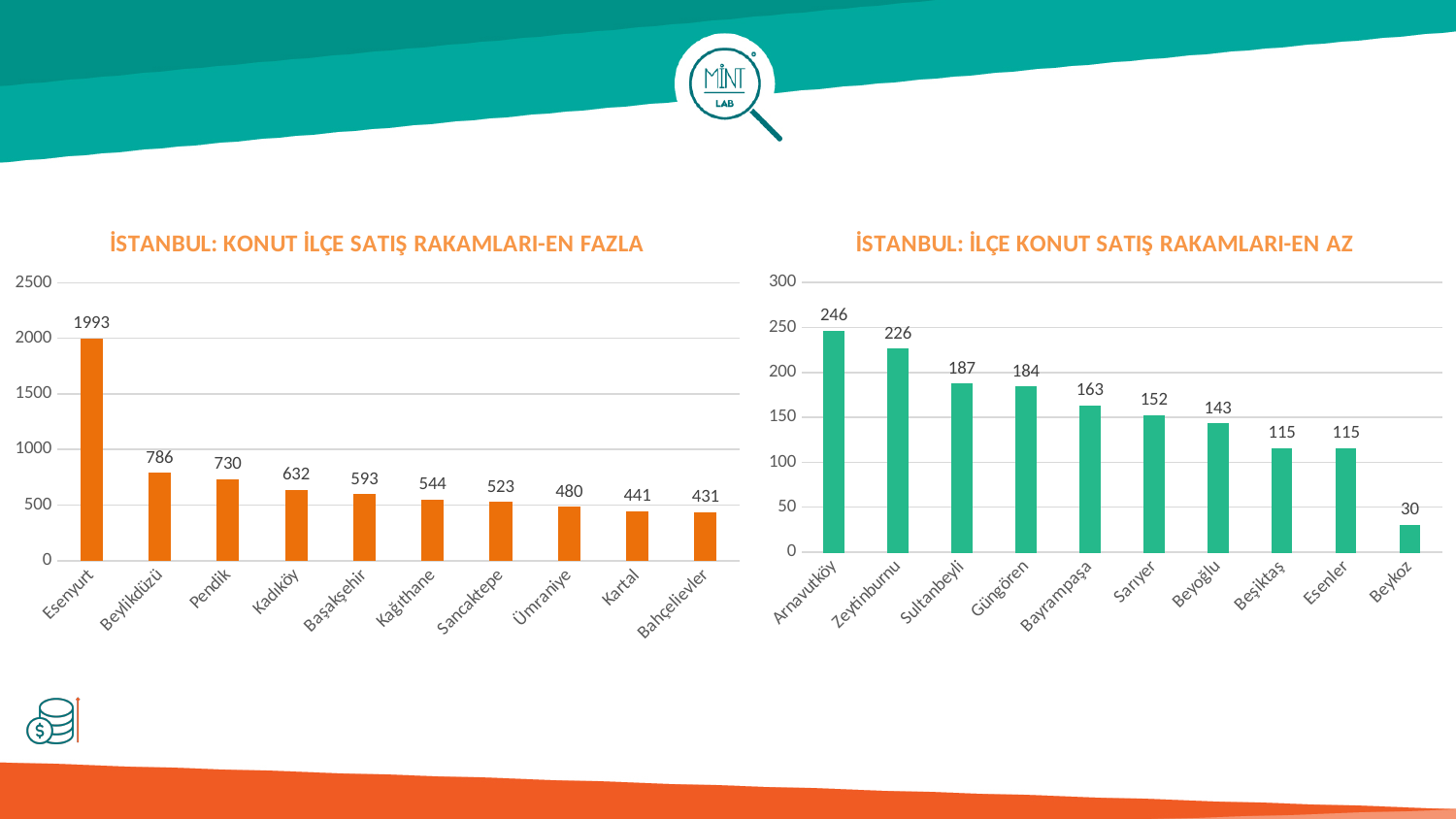
In the chart titled 'İSTANBUL: KONUT İLÇE SATIŞ RAKAMLARI-EN FAZLA', which district has the lowest value? Bahçelievler In the chart titled 'İSTANBUL: İLÇE KONUT SATIŞ RAKAMLARI-EN AZ', which is larger, Sarıyer or Beyoğlu? Sarıyer In the chart titled 'İSTANBUL: KONUT İLÇE SATIŞ RAKAMLARI-EN FAZLA', what is the value for Esenyurt? 1993 In the chart titled 'İSTANBUL: İLÇE KONUT SATIŞ RAKAMLARI-EN AZ', what is the value for Bayrampaşa? 163 In the chart titled 'İSTANBUL: KONUT İLÇE SATIŞ RAKAMLARI-EN FAZLA', what is the difference between Esenyurt and Beylikdüzü? 1207 In the chart titled 'İSTANBUL: KONUT İLÇE SATIŞ RAKAMLARI-EN FAZLA', how many districts are shown? 10 In the chart titled 'İSTANBUL: İLÇE KONUT SATIŞ RAKAMLARI-EN AZ', what is the difference between Zeytinburnu and Sultanbeyli? 39 In the chart titled 'İSTANBUL: KONUT İLÇE SATIŞ RAKAMLARI-EN FAZLA', what is the value for Kadıköy? 632 What type of chart is the chart titled 'İSTANBUL: İLÇE KONUT SATIŞ RAKAMLARI-EN AZ'? bar chart In the chart titled 'İSTANBUL: İLÇE KONUT SATIŞ RAKAMLARI-EN AZ', which district has the lowest value? Beykoz In the chart titled 'İSTANBUL: KONUT İLÇE SATIŞ RAKAMLARI-EN FAZLA', do the values rise or fall from left to right? fall In the chart titled 'İSTANBUL: İLÇE KONUT SATIŞ RAKAMLARI-EN AZ', which district has the highest value? Arnavutköy